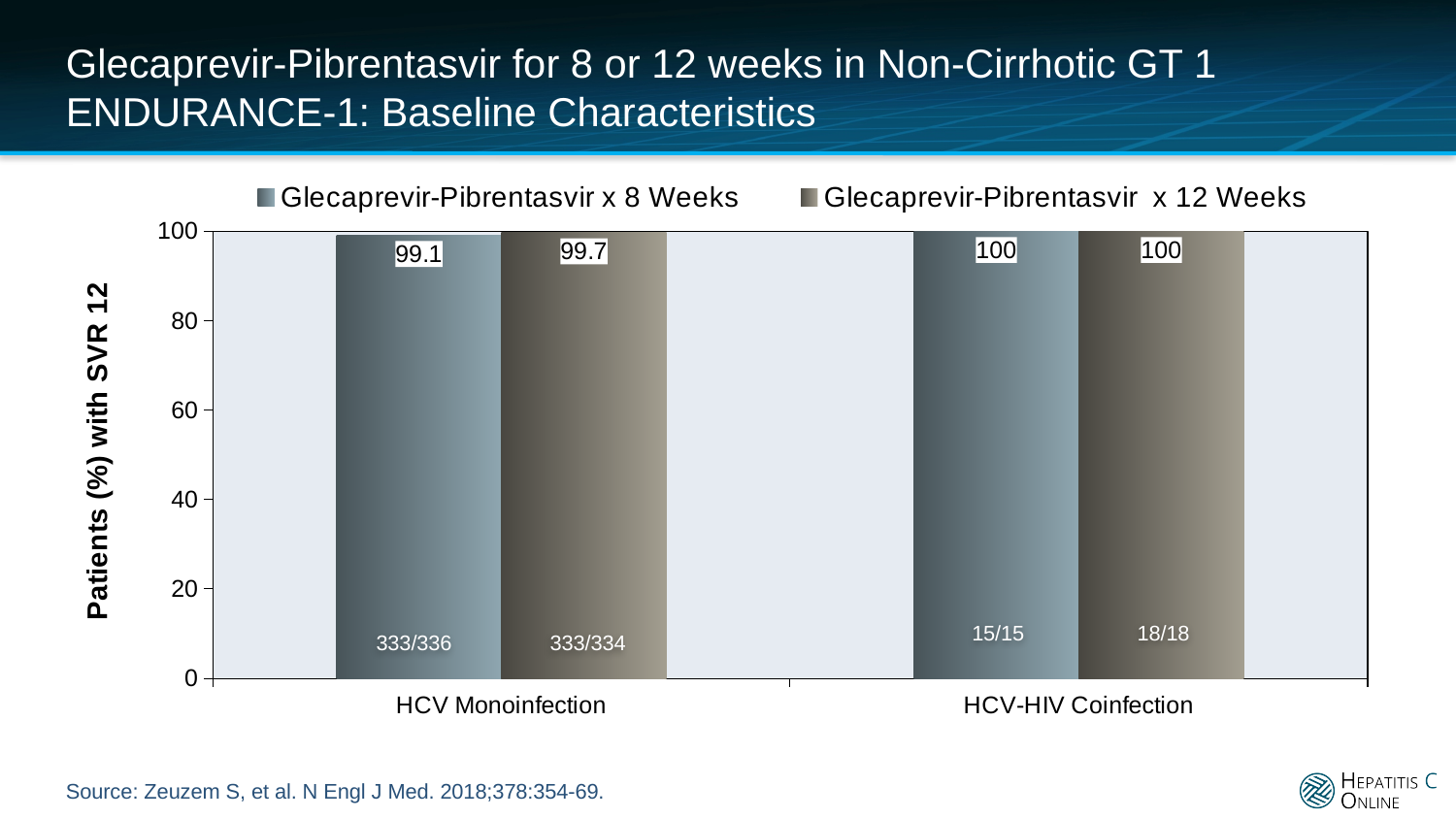
What kind of chart is shown on the slide? Bar chart What is the label of the y axis? Patients (%) with SVR 12 What fraction of patients is shown on the Glecaprevir-Pibrentasvir x 12 Weeks bar for HCV-HIV Coinfection? 18/18 Is the SVR 12 rate for Glecaprevir-Pibrentasvir x 8 Weeks in HCV Monoinfection greater or less than 80? greater What is the SVR 12 rate for Glecaprevir-Pibrentasvir x 8 Weeks in the HCV Monoinfection group? 99.1 What fraction of patients is shown on the Glecaprevir-Pibrentasvir x 8 Weeks bar for HCV Monoinfection? 333/336 How many series does the legend list? 2 What is the SVR 12 rate for Glecaprevir-Pibrentasvir x 12 Weeks in the HCV Monoinfection group? 99.7 What is the SVR 12 rate for Glecaprevir-Pibrentasvir x 8 Weeks in the HCV-HIV Coinfection group? 100 Which has the lower SVR 12 rate in the HCV Monoinfection group, the 8-week or the 12-week regimen? Glecaprevir-Pibrentasvir x 8 Weeks How many patient groups are shown on the x axis? 2 What is the difference between the 12-week and 8-week SVR 12 rates in the HCV Monoinfection group? 0.6